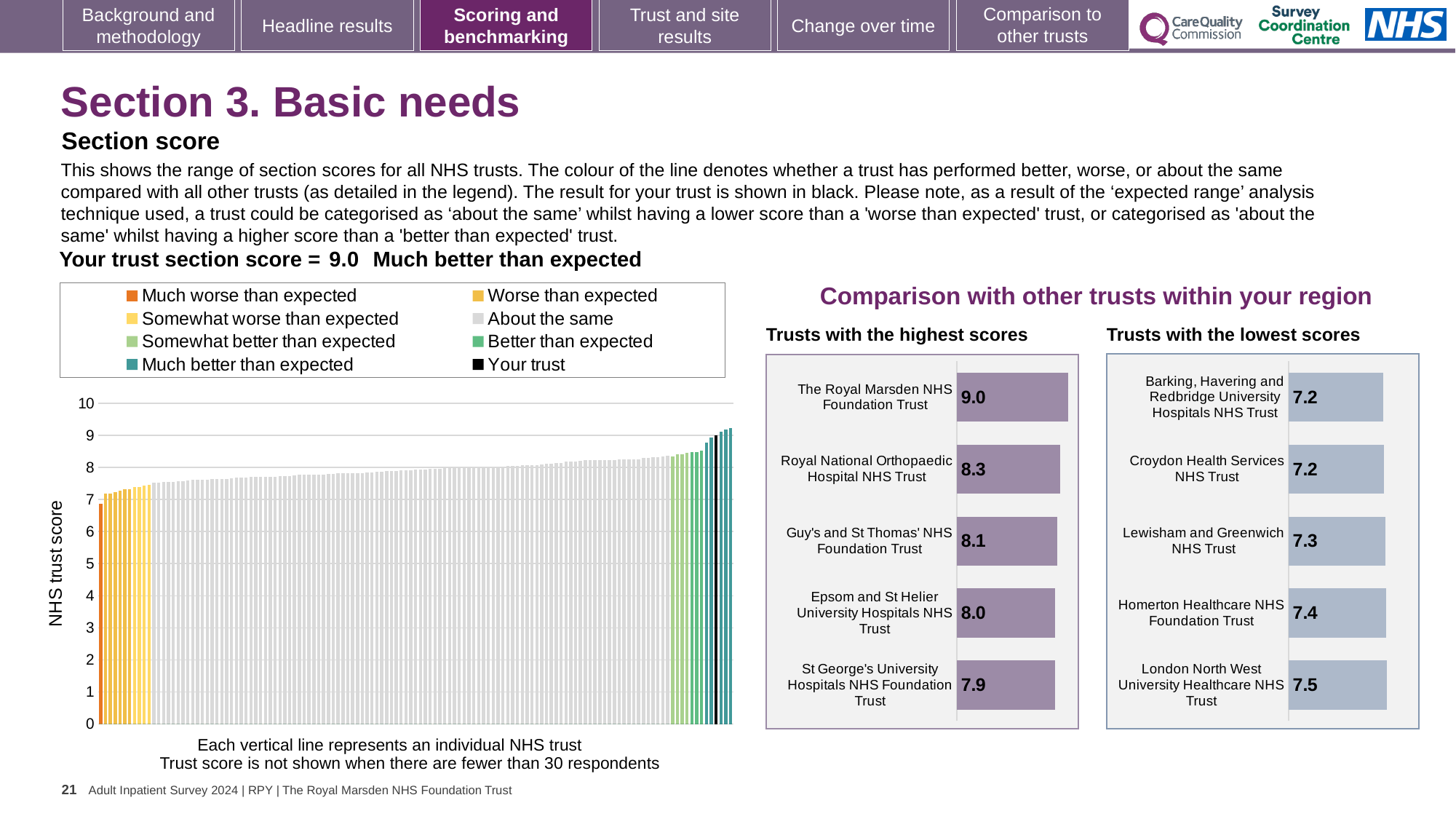
In the 'Trusts with the highest scores' chart, what is the score for The Royal Marsden NHS Foundation Trust? 9.0 In the large chart on the left showing the range of section scores, how many entries does the legend list? 8 In the 'Trusts with the highest scores' chart, how many trusts are shown? 5 In the 'Trusts with the highest scores' chart, what is the difference between the scores of The Royal Marsden NHS Foundation Trust and St George's University Hospitals NHS Foundation Trust? 1.1 In the large chart on the left showing the range of section scores, what is the label on the vertical axis? NHS trust score In the 'Trusts with the lowest scores' chart, which has the larger score: Lewisham and Greenwich NHS Trust or Homerton Healthcare NHS Foundation Trust? Homerton Healthcare NHS Foundation Trust In the 'Trusts with the lowest scores' chart, which trust has the highest score? London North West University Healthcare NHS Trust In the 'Trusts with the highest scores' chart, what is the score for Guy's and St Thomas' NHS Foundation Trust? 8.1 In the large chart on the left showing the range of section scores, what kind of chart is it? Bar chart In the 'Trusts with the lowest scores' chart, what is the score for Homerton Healthcare NHS Foundation Trust? 7.4 In the 'Trusts with the lowest scores' chart, what is the difference between the scores of London North West University Healthcare NHS Trust and Croydon Health Services NHS Trust? 0.3 In the 'Trusts with the highest scores' chart, which trust has the lowest score? St George's University Hospitals NHS Foundation Trust